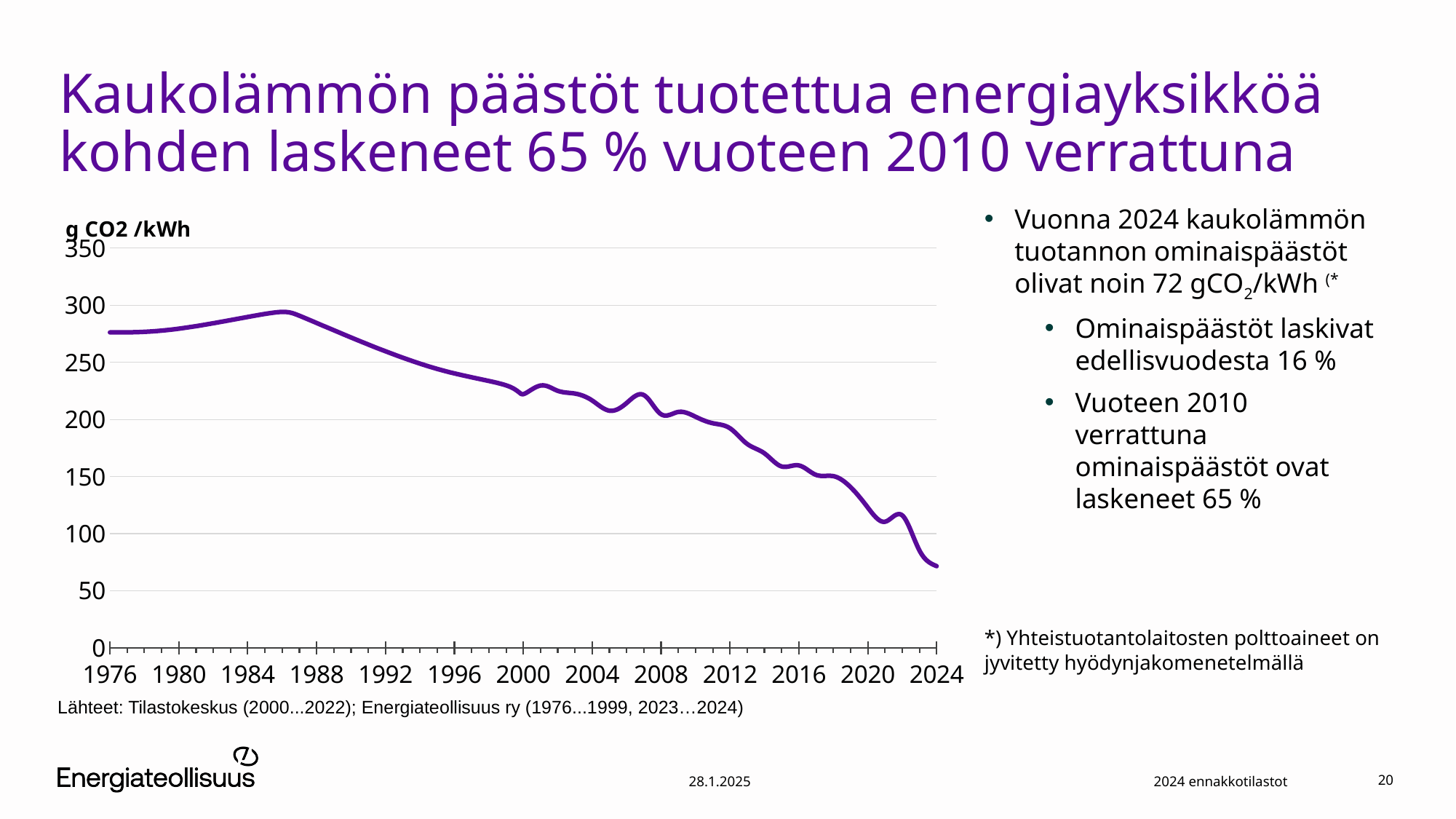
Which is larger, the value for 2008 or the value for 2016? 2008 Is the value for 2024 greater or less than 100? less Is the value for 2016 greater or less than 200? less Is the value for 2020 greater or less than 150? less What unit label is shown above the vertical axis of the chart? g CO2 /kWh Do the values in the chart generally rise or fall from 1976 to 2024? fall What kind of chart is shown on the slide? line chart Which is larger, the value for 1976 or the value for 2024? 1976 Which year has the lowest value in the chart? 2024